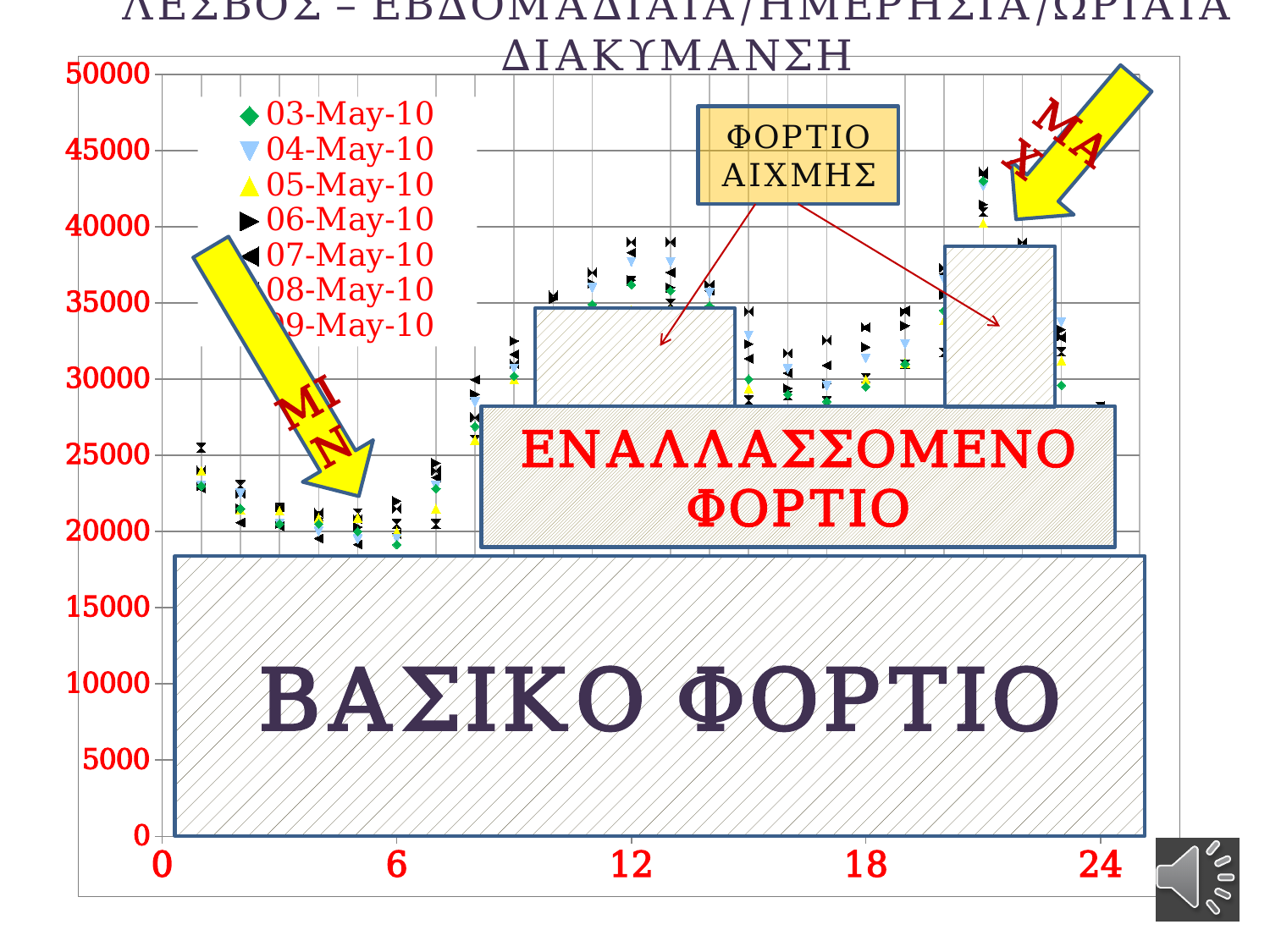
What kind of chart is shown on the slide? scatter chart What is the highest value shown on the chart's y axis? 50000 Do the plotted values rise or fall between hour 1 and hour 5? fall Which hour has higher plotted values, hour 5 or hour 21? hour 21 Do the plotted values rise or fall between hour 7 and hour 12? rise Are the plotted values at hour 12 greater or less than 30000? greater Are the plotted values at hour 1 greater or less than 30000? less Around which hour do the plotted values reach their maximum? 21 Are the plotted values at hour 5 greater or less than 25000? less How many series does the chart's legend list? 7 What is the first series listed in the chart's legend? 03-May-10